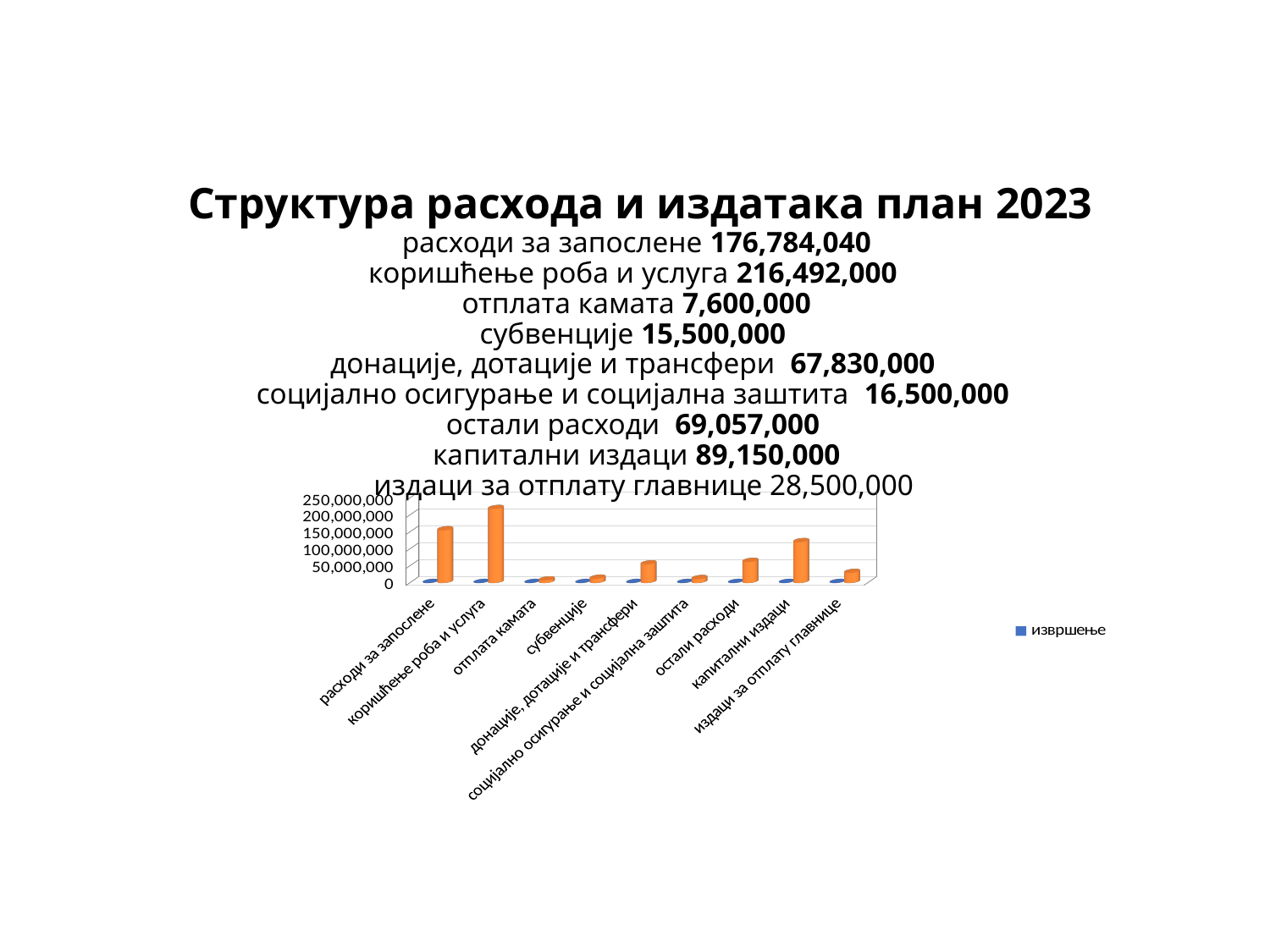
Which has the taller bar: капитални издаци or остали расходи? капитални издаци What is the legend entry shown next to the chart? извршење Is the value for коришћење роба и услуга greater or less than 200,000,000? greater Is the value for капитални издаци greater or less than 100,000,000? greater According to the values printed on the slide, what is the difference between коришћење роба и услуга and расходи за запослене? 39,707,960 According to the values printed on the slide, what is the planned amount for субвенције? 15,500,000 How many categories are shown on the x axis of the chart? 9 How many series does the chart legend list? 1 What kind of chart is shown on the slide? bar chart Is the value for издаци за отплату главнице greater or less than 50,000,000? less Which category has the tallest orange bar in the chart? коришћење роба и услуга